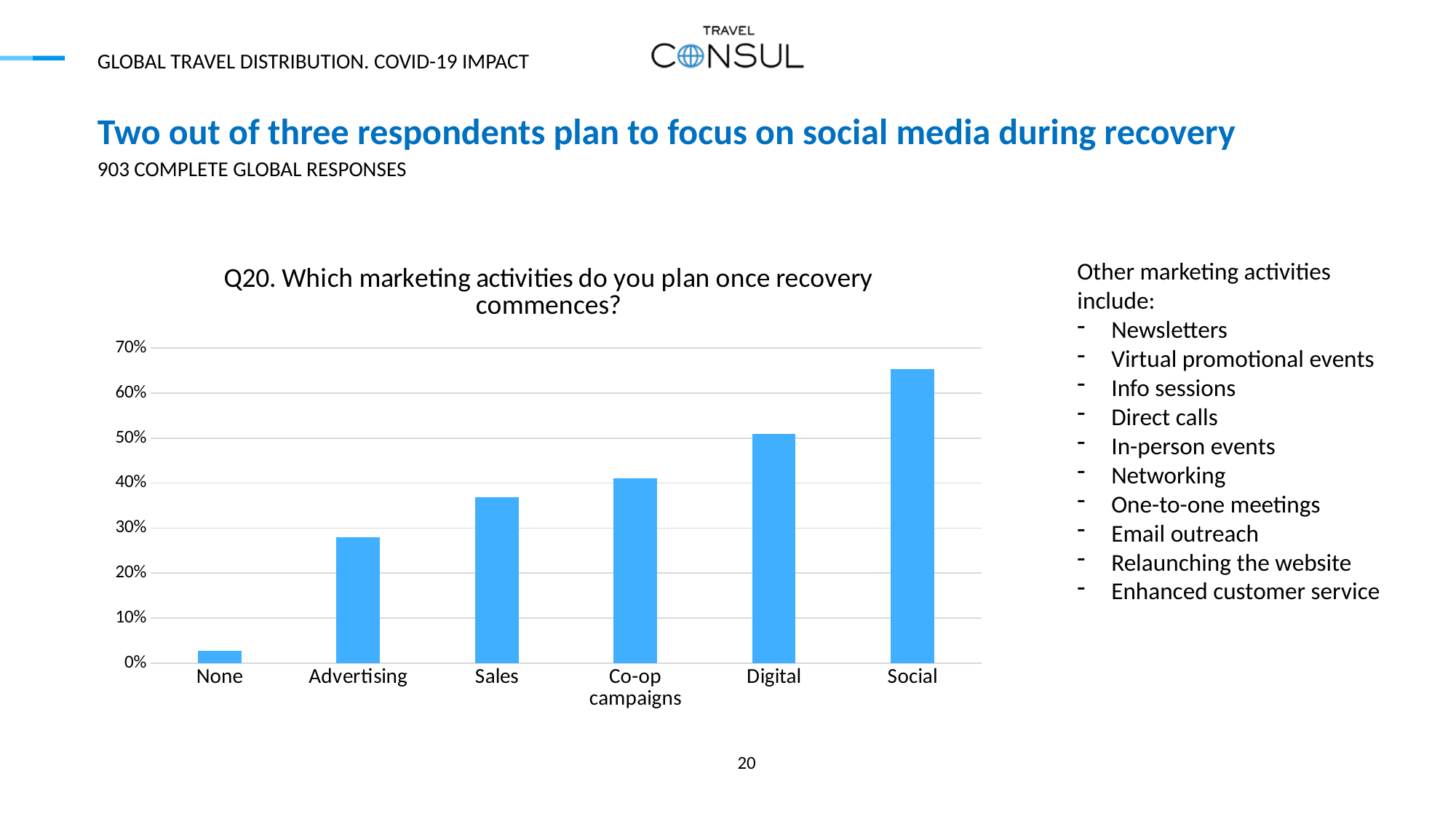
Which marketing activity has the highest value in the chart? Social Which marketing activity has the lowest value in the chart? None Is the value for None greater or less than 10%? less Is the value for Digital greater or less than 40%? greater Do the values rise or fall moving from left to right along the x axis? rise Is the value for Advertising greater or less than 20%? greater Which is larger, the value for Digital or the value for Co-op campaigns? Digital How many categories are shown on the x axis of the chart? 6 What is the title of the chart? Q20. Which marketing activities do you plan once recovery commences? What kind of chart is shown on the slide? bar chart